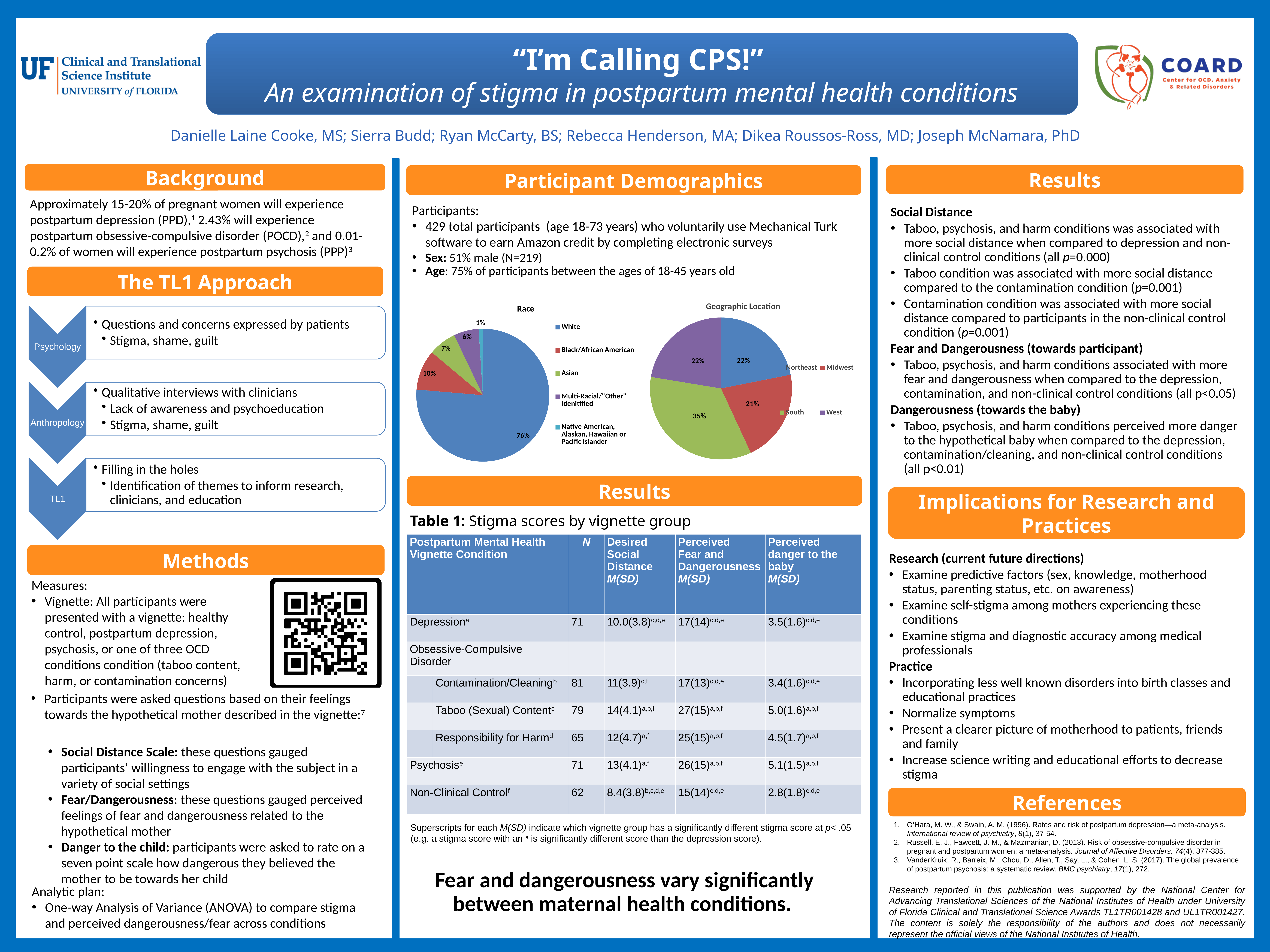
In the Race chart, how many categories does the legend list? 5 In the Race chart, what percentage of participants are Black/African American? 10% In the Geographic Location chart, which region has the largest share? South In the Race chart, what share of participants are White? 76% In the Race chart, what is the difference in percentage points between the White and Black/African American slices? 66 In the Geographic Location chart, what percentage of participants are from the South? 35% In the Race chart, which category has the smallest slice? Native American, Alaskan, Hawaiian or Pacific Islander In the Race chart, what percentage of participants are Asian? 7% What type of chart is used for the Geographic Location data? Pie chart In the Geographic Location chart, how many regions are shown? 4 In the Geographic Location chart, what percentage of participants are from the Midwest? 21% In the Race chart, which category has the largest slice? White